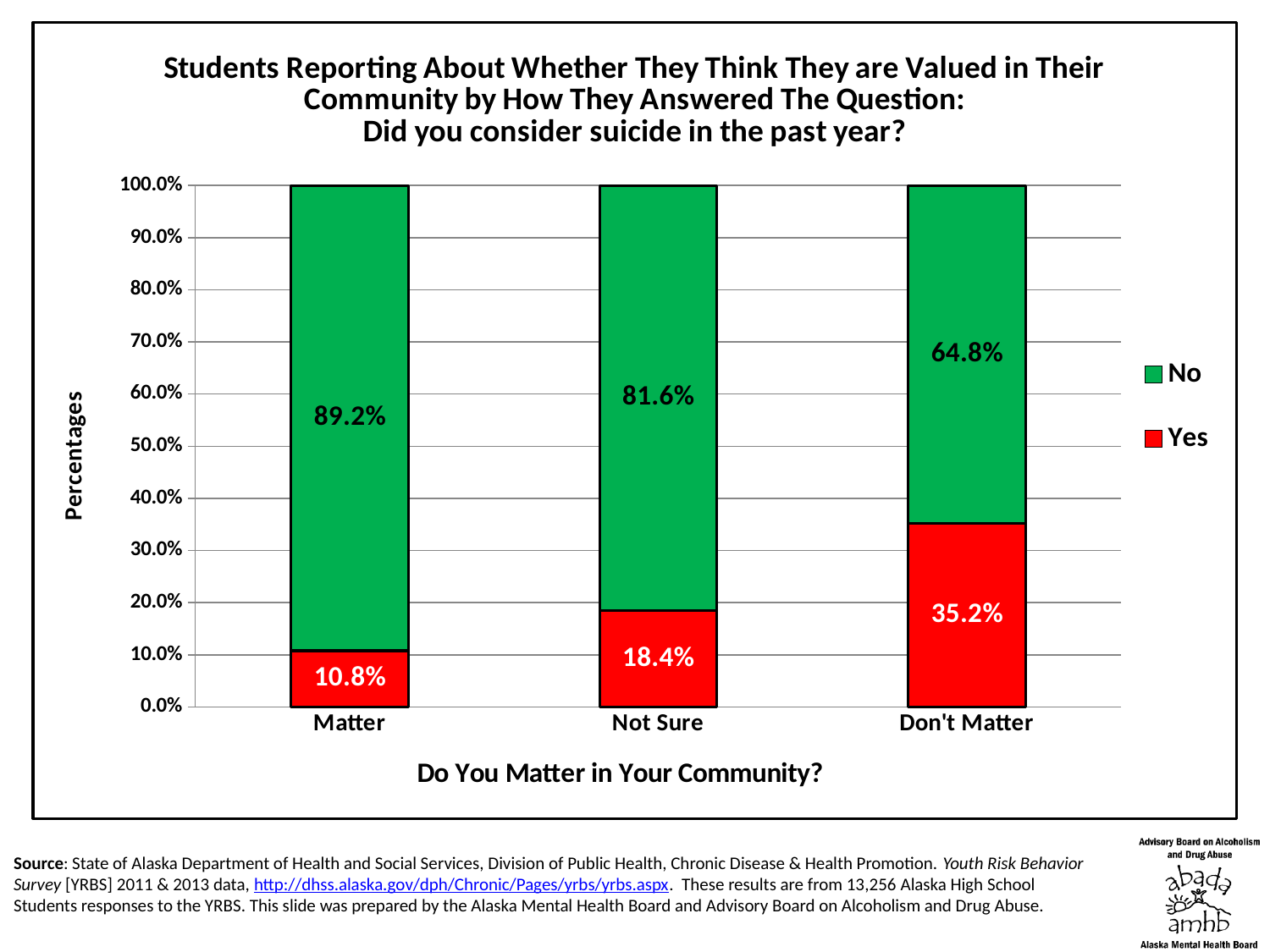
Which is larger: the No value for "Matter" or the No value for "Not Sure"? Matter What percentage of students who answered "Matter" said Yes to considering suicide in the past year? 10.8% Which category has the lowest No percentage? Don't Matter What percentage of students who answered "Don't Matter" said No to considering suicide in the past year? 64.8% Which category has the highest Yes percentage? Don't Matter What is the x-axis title of the chart? Do You Matter in Your Community? What kind of chart is shown on the slide? Stacked bar chart How many series does the legend list? 2 Is the Yes value for "Don't Matter" greater or less than 30.0%? greater How many categories are shown on the x axis? 3 What is the difference between the Yes percentages for "Don't Matter" and "Matter"? 24.4% What is the Yes value for the "Not Sure" category? 18.4%